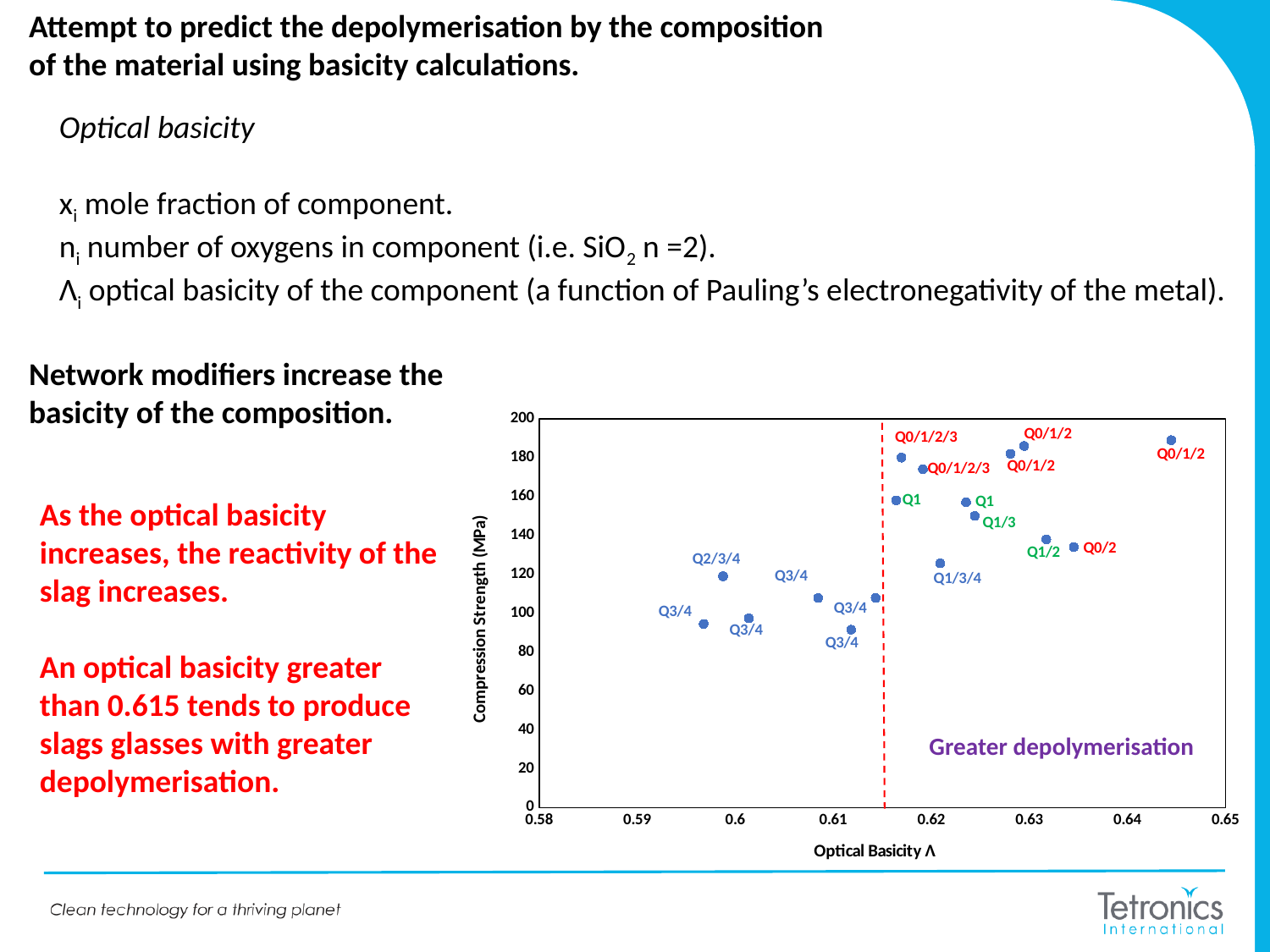
What is the title of the x axis of the chart? Optical Basicity Λ Which has the higher compression strength, the point labelled Q1/2 or the point labelled Q1/3? Q1/3 As optical basicity increases along the x axis, do the compression strength values generally rise or fall? rise What kind of chart is shown on the slide? Scatter chart Is the compression strength of the point labelled Q1/3 greater or less than 140? greater Is the compression strength of the point labelled Q1/3/4 greater or less than 140? less Is the compression strength of the point labelled Q1/2 greater or less than 160? less What is the title of the y axis of the chart? Compression Strength (MPa) Which has the higher compression strength, the point labelled Q1 at about 0.617 optical basicity or the point labelled Q2/3/4? Q1